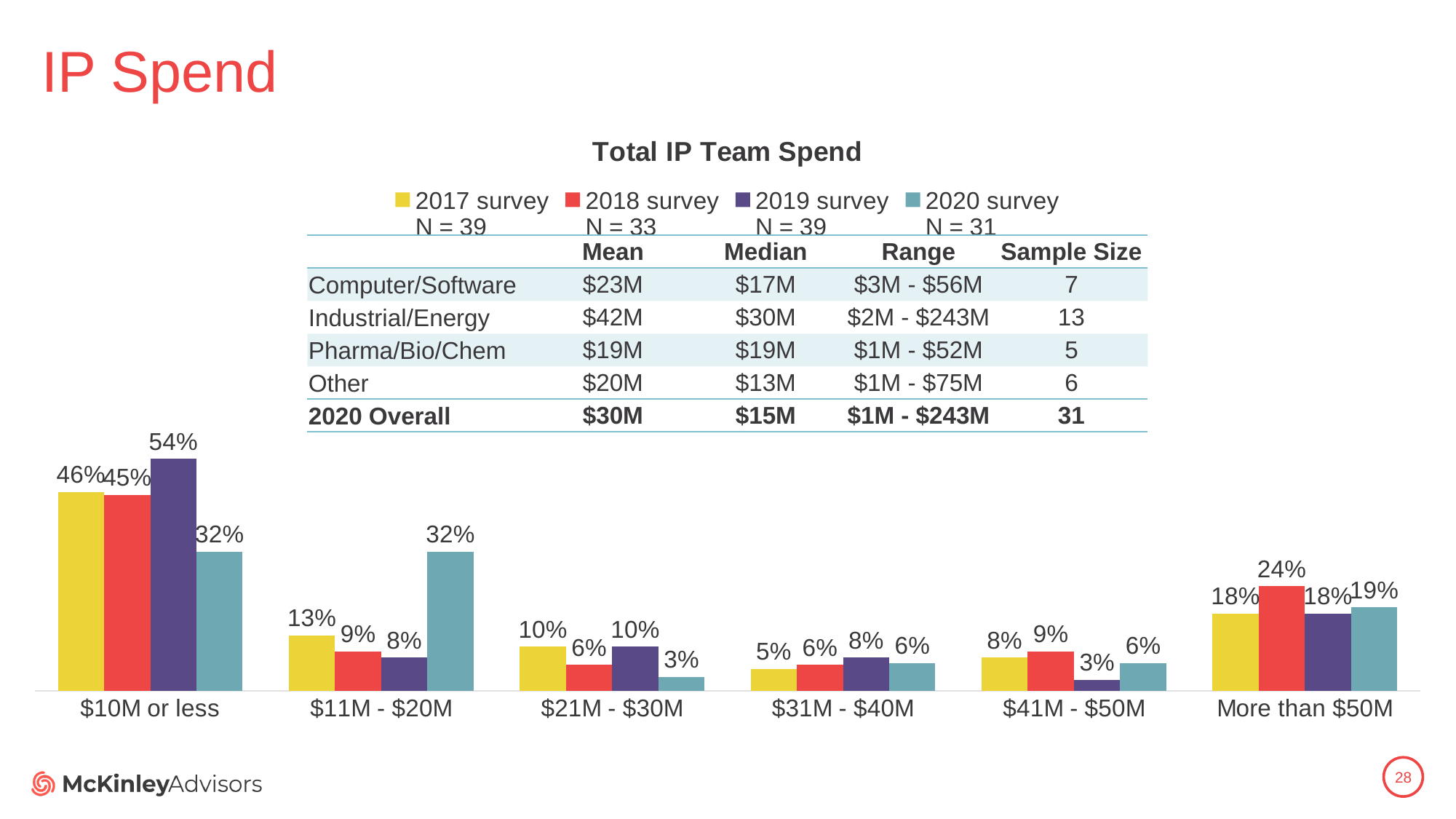
Which category has the highest value for the 2020 survey? $10M or less and $11M - $20M (tied at 32%) How many series does the legend list? 4 How many spend categories are shown on the x axis? 6 What is the difference between the 2019 survey and 2020 survey values in the "$10M or less" category? 22 percentage points What kind of chart is shown on the slide? Bar chart In the "$21M - $30M" category, which is larger: the 2017 survey value or the 2020 survey value? 2017 survey What is the value for the 2017 survey in the "$31M - $40M" category? 5% What is the value for the 2019 survey in the "$10M or less" category? 54% What is the sample size (N) for the 2020 survey shown in the legend? N = 31 What is the value for the 2020 survey in the "$11M - $20M" category? 32% Which category has the lowest value for the 2019 survey? $41M - $50M What is the value for the 2018 survey in the "More than $50M" category? 24%